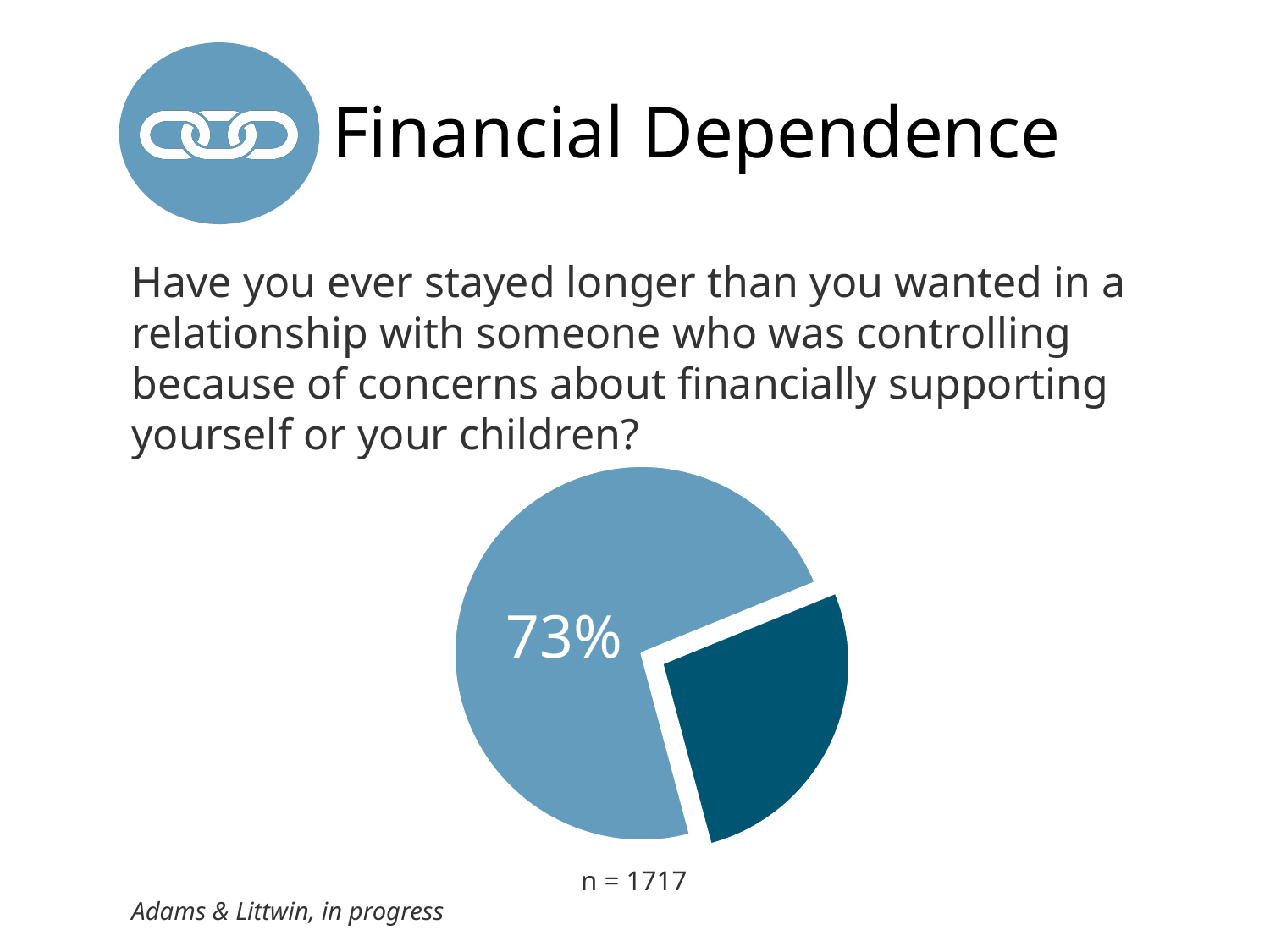
Which slice of the pie chart is larger, the light blue slice or the dark blue slice? the light blue slice How many slices does the pie chart have? 2 What is the title of the slide containing the pie chart? Financial Dependence Which slice of the pie chart is the largest? the light blue slice (73%) What percentage is printed on the large light blue slice of the pie chart? 73% Is the light blue slice of the pie chart greater or less than 50% of the pie? greater What share of the pie does the light blue slice represent? 73% What sample size (n) is shown below the pie chart? n = 1717 Is the dark blue slice of the pie chart greater or less than 50% of the pie? less What kind of chart is shown on the slide? pie chart